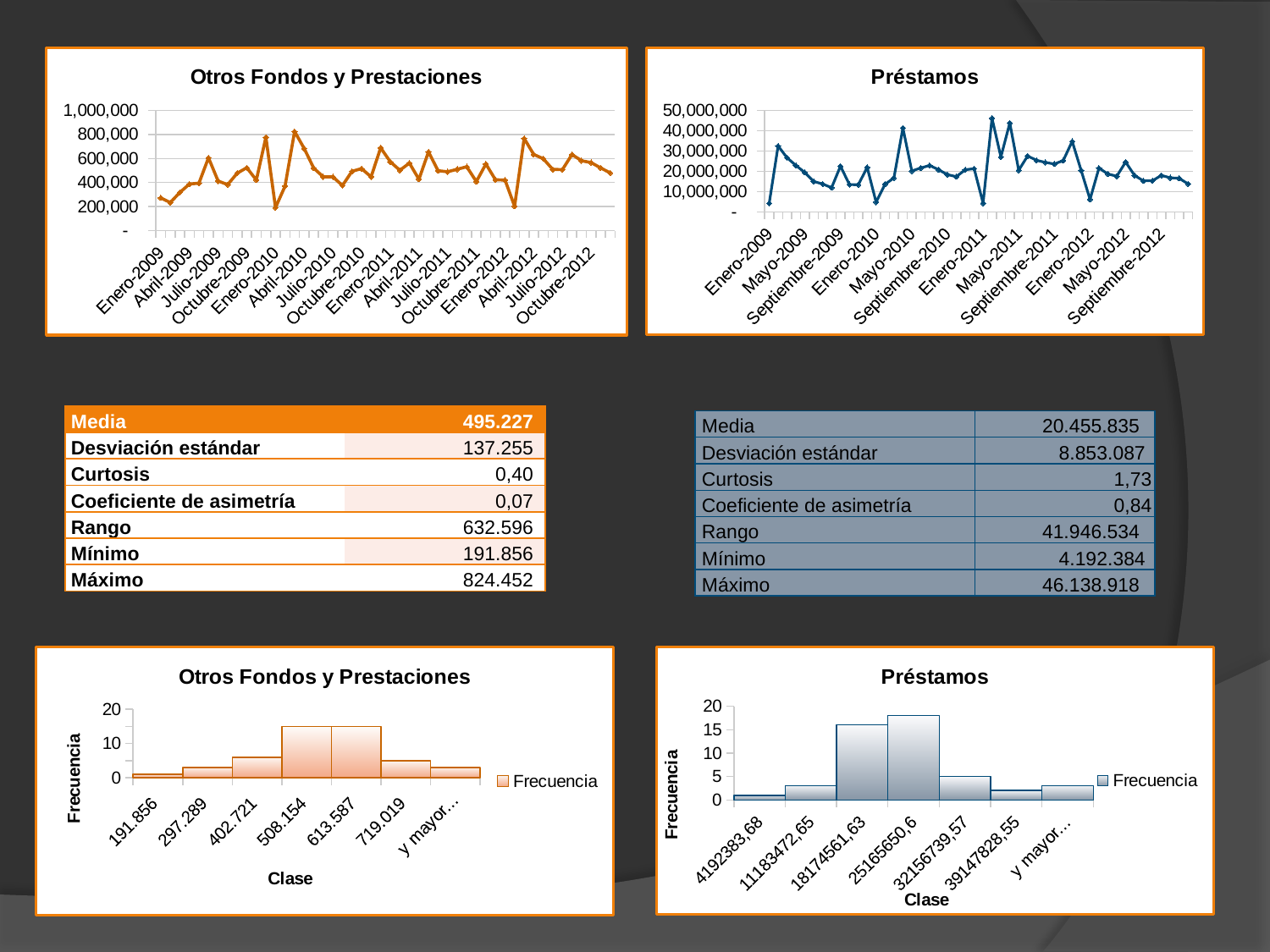
In the bottom-left "Otros Fondos y Prestaciones" bar chart, which class has the lowest frequency? 191.856 How many classes (categories) are shown on the x axis of the bottom-left "Otros Fondos y Prestaciones" bar chart? 7 In the bottom-left "Otros Fondos y Prestaciones" bar chart, is the frequency for class 508.154 greater or less than 10? greater In the top-right line chart "Préstamos", is the value for Enero-2009 greater or less than 10,000,000? less How many series does the legend of the bottom-right "Préstamos" bar chart list? 1 What kind of chart is the bottom-left chart titled "Otros Fondos y Prestaciones"? bar chart What kind of chart is the top-left chart titled "Otros Fondos y Prestaciones"? line chart What is the y-axis title of the bottom-left "Otros Fondos y Prestaciones" bar chart? Frecuencia In the bottom-right "Préstamos" bar chart, which class has the highest frequency? 25165650,6 In the bottom-right "Préstamos" bar chart, which has the larger frequency: class 11183472,65 or class 25165650,6? 25165650,6 In the top-left line chart "Otros Fondos y Prestaciones", is the value for Enero-2009 greater or less than 400,000? less